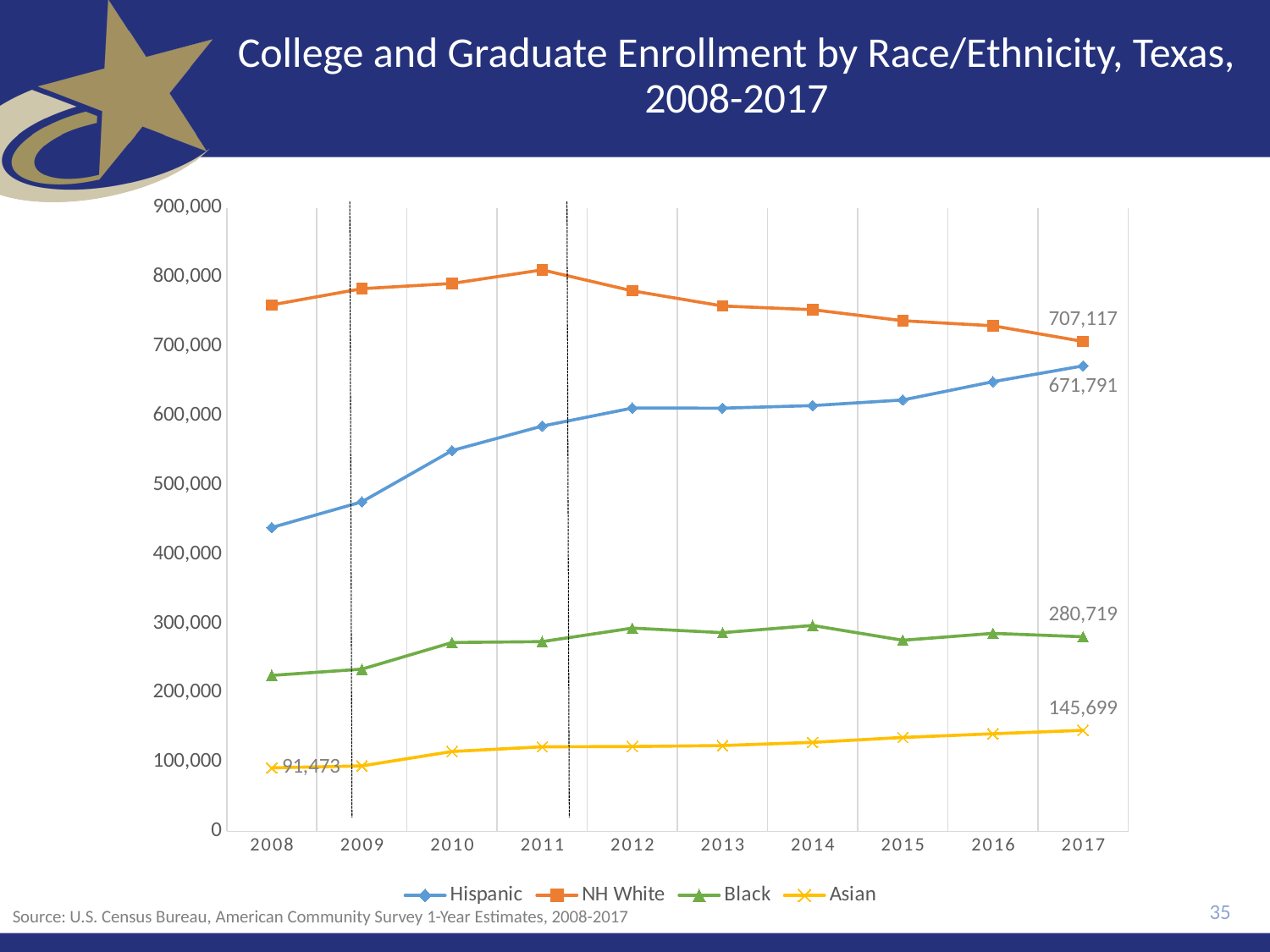
Does the Hispanic series rise or fall from 2008 to 2017? rise Which series has the highest value in 2017? NH White Is the Hispanic value for 2008 greater or less than 500,000? less What is the Black enrollment value labelled for 2017? 280,719 How many series does the legend list? 4 How many years are shown on the x axis? 10 Which series has the lowest value in 2008? Asian What is the NH White enrollment value labelled for 2017? 707,117 What is the Hispanic enrollment value labelled for 2017? 671,791 What is the difference between the NH White and Hispanic values labelled for 2017? 35,326 What is the Asian enrollment value labelled for 2008? 91,473 What kind of chart is shown on the slide? line chart